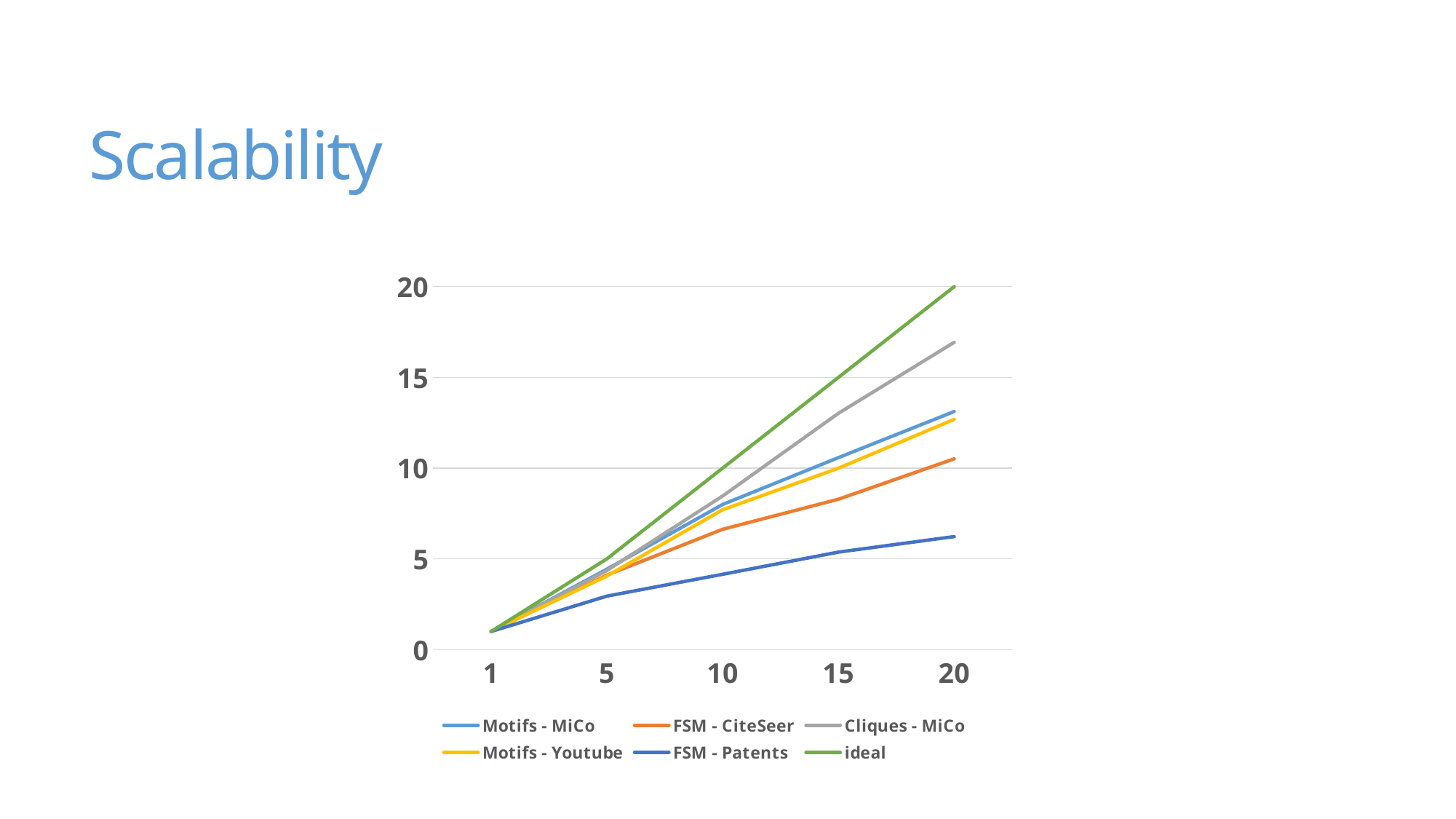
Is the value for FSM - Patents at x = 10 greater or less than 5? less How many points are on the x axis? 5 What is the title of the slide? Scalability What is the value of the ideal series at x = 20? 20 How many series does the legend list? 6 Is the value for Cliques - MiCo at x = 20 greater or less than 15? greater Which series has the lowest value at x = 20? FSM - Patents Which series has the highest value at x = 20? ideal At x = 20, which is larger: Cliques - MiCo or Motifs - MiCo? Cliques - MiCo What kind of chart is shown on the slide? line chart What is the value of the ideal series at x = 10? 10 Do the values of the FSM - CiteSeer series rise or fall as x increases? rise